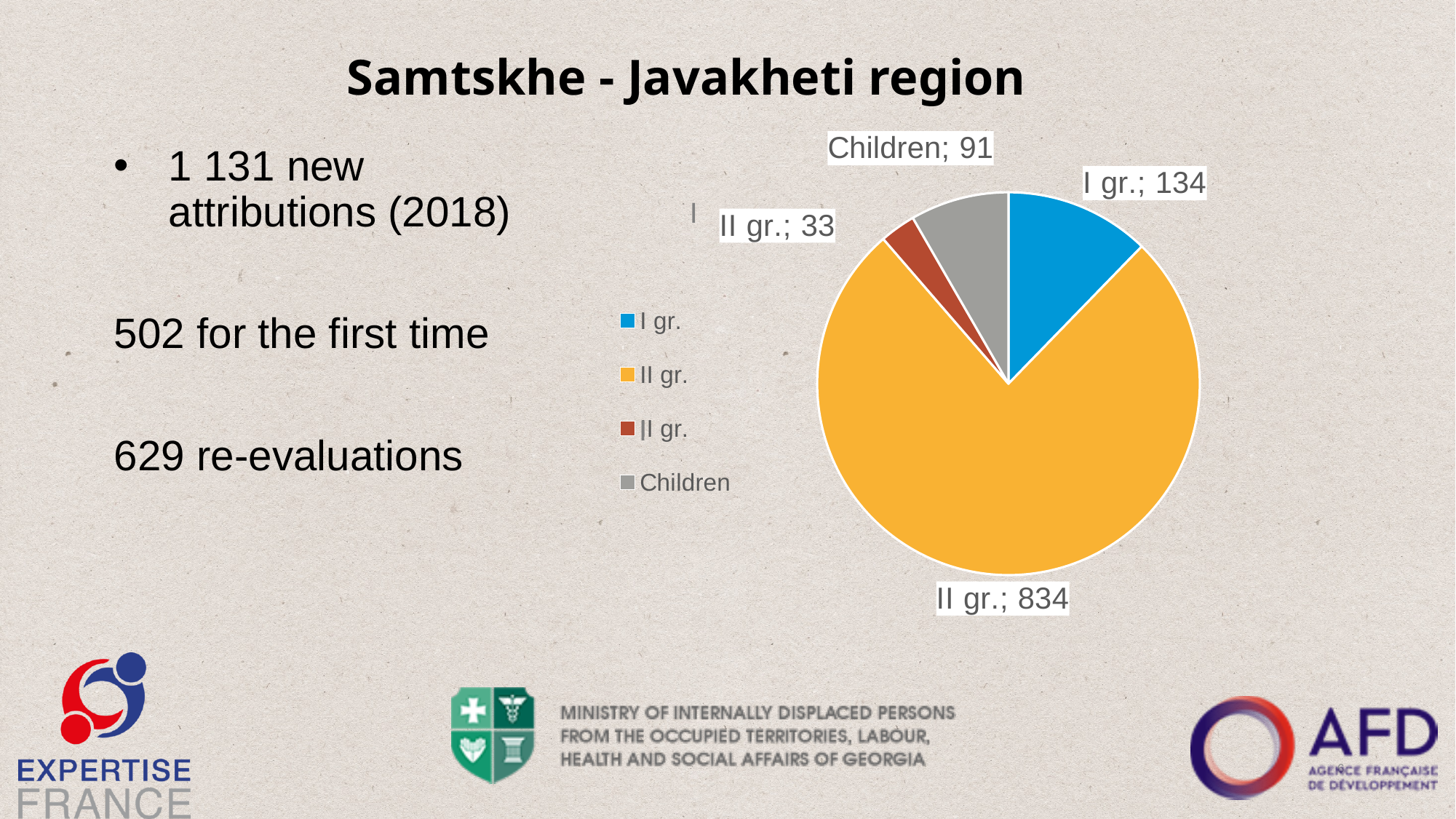
Which category has the smallest slice in the pie chart? III gr. What value is shown for Children in the pie chart? 91 How many categories are shown in the pie chart? 4 Which category has the largest slice in the pie chart? II gr. What type of chart is shown on the slide? pie chart Which is larger, the value for Children or the value for I gr.? I gr. What is the total of all the values shown in the pie chart? 1092 What value is shown for I gr. in the pie chart? 134 What is the difference between the I gr. value and the Children value? 43 What value is shown for the red slice (III gr.) in the pie chart? 33 What is the difference between the II gr. value and the I gr. value? 700 What value is shown for II gr. in the pie chart? 834